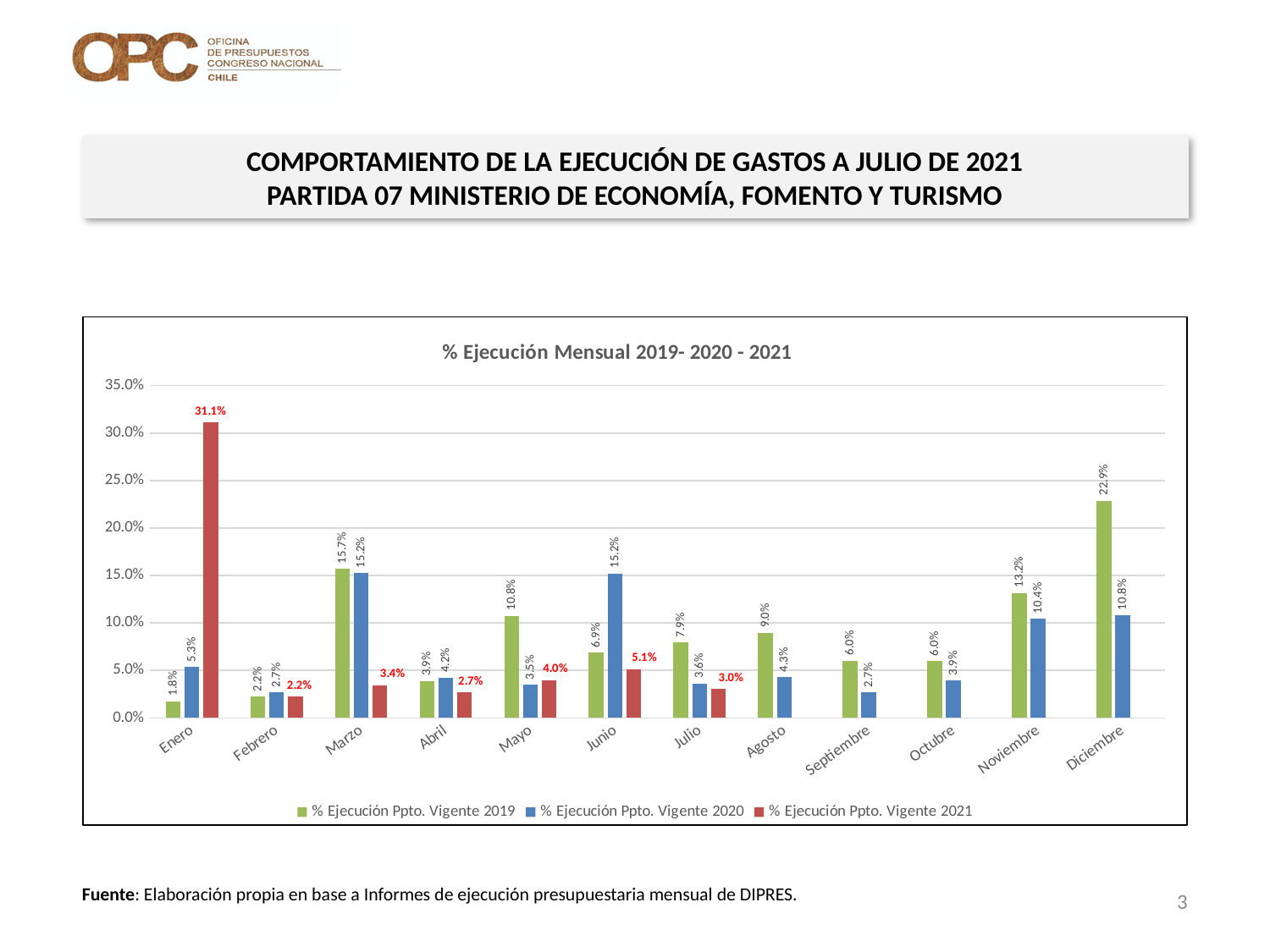
Which month has the lowest value for % Ejecución Ppto. Vigente 2019? Enero What type of chart is shown on the slide? bar chart Is the value for % Ejecución Ppto. Vigente 2021 in Enero greater or less than 30.0%? greater Which month has the highest value for % Ejecución Ppto. Vigente 2021? Enero What is the title of the chart? % Ejecución Mensual 2019- 2020 - 2021 What is the difference between the 2019 and 2020 values in Noviembre? 2.8% What is the value for % Ejecución Ppto. Vigente 2020 in Junio? 15.2% How many months are shown on the x axis? 12 How many series does the legend list? 3 What is the value for % Ejecución Ppto. Vigente 2019 in Diciembre? 22.9% In Mayo, which series has the larger value: % Ejecución Ppto. Vigente 2019 or % Ejecución Ppto. Vigente 2020? % Ejecución Ppto. Vigente 2019 What is the value for % Ejecución Ppto. Vigente 2021 in Enero? 31.1%